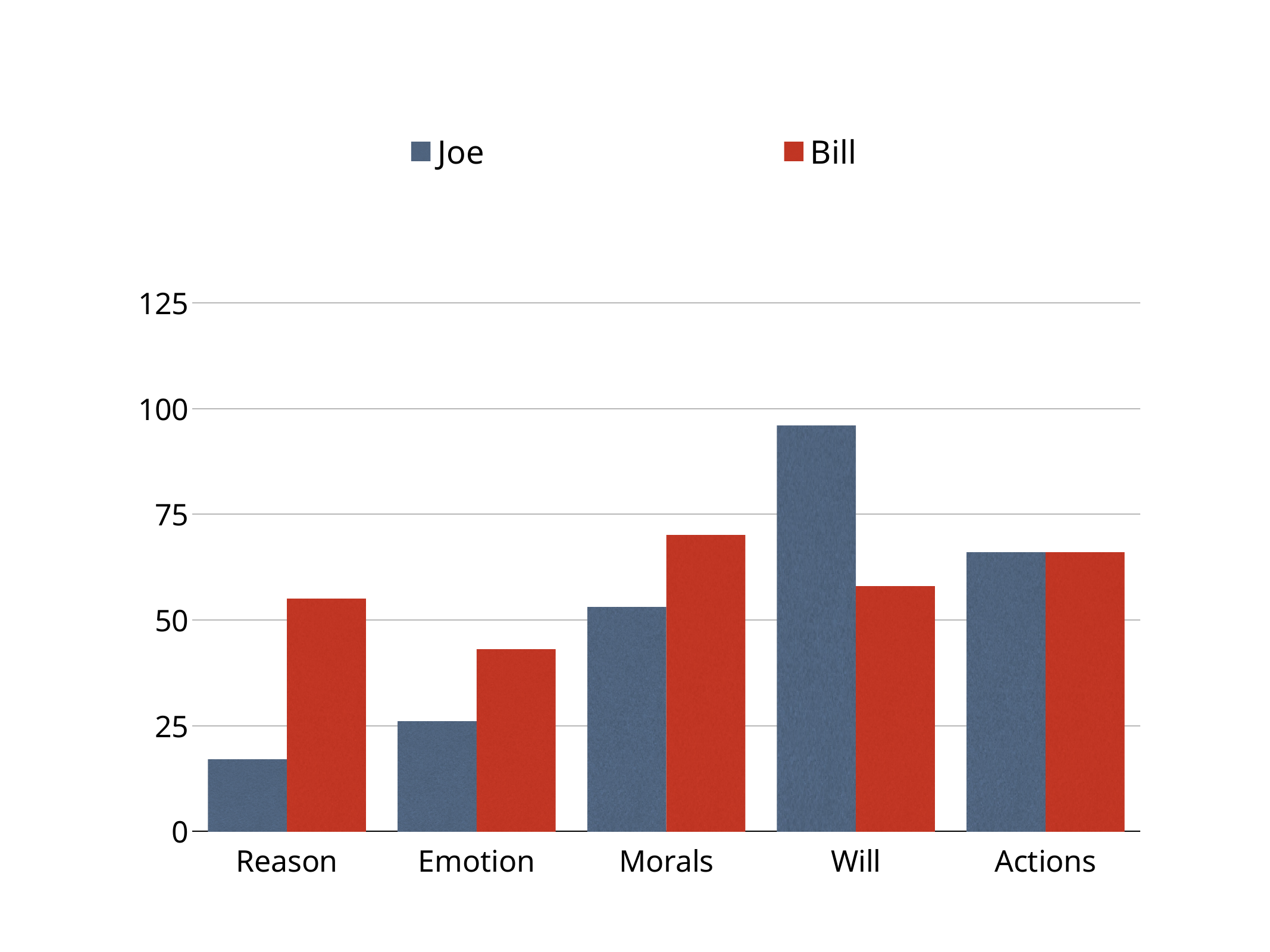
Is the value for Joe in the Will category greater or less than 75? greater Which category has the highest value for Joe? Will In the Will category, who has the larger value, Joe or Bill? Joe How many categories are shown on the x axis? 5 Is the value for Bill in the Morals category greater or less than 75? less What kind of chart is shown on the slide? bar chart How many series does the legend list? 2 In the Reason category, who has the larger value, Joe or Bill? Bill Is the value for Bill in the Emotion category greater or less than 50? less Which category has the lowest value for Bill? Emotion Which category has the lowest value for Joe? Reason